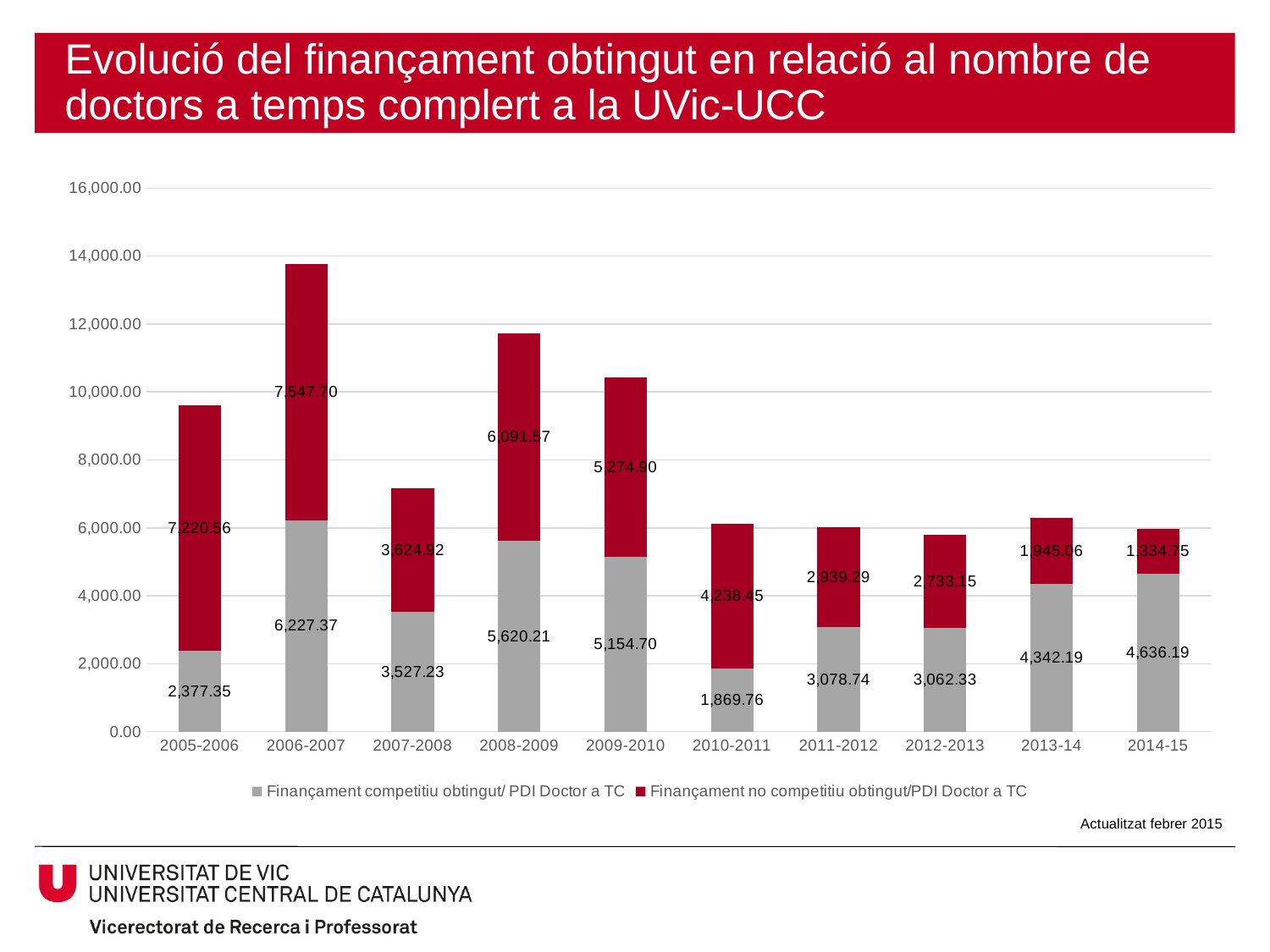
How many series does the legend list? 2 How many periods are shown on the x axis? 10 In 2008-2009, which is larger: 'Finançament competitiu obtingut/ PDI Doctor a TC' or 'Finançament no competitiu obtingut/PDI Doctor a TC'? Finançament no competitiu obtingut/PDI Doctor a TC Which period has the highest value for 'Finançament no competitiu obtingut/PDI Doctor a TC'? 2006-2007 What is the value of 'Finançament competitiu obtingut/ PDI Doctor a TC' for 2013-14? 4,342.19 What is the total of the stacked bar for 2006-2007? 13,775.07 What is the difference between the competitive and non-competitive funding values for 2014-15? 3,301.44 What is the value of 'Finançament no competitiu obtingut/PDI Doctor a TC' for 2010-2011? 4,238.45 What kind of chart is shown on the slide? Stacked bar chart What is the value of 'Finançament competitiu obtingut/ PDI Doctor a TC' for 2005-2006? 2,377.35 Which period has the lowest value for 'Finançament competitiu obtingut/ PDI Doctor a TC'? 2010-2011 Which period has the lowest value for 'Finançament no competitiu obtingut/PDI Doctor a TC'? 2014-15